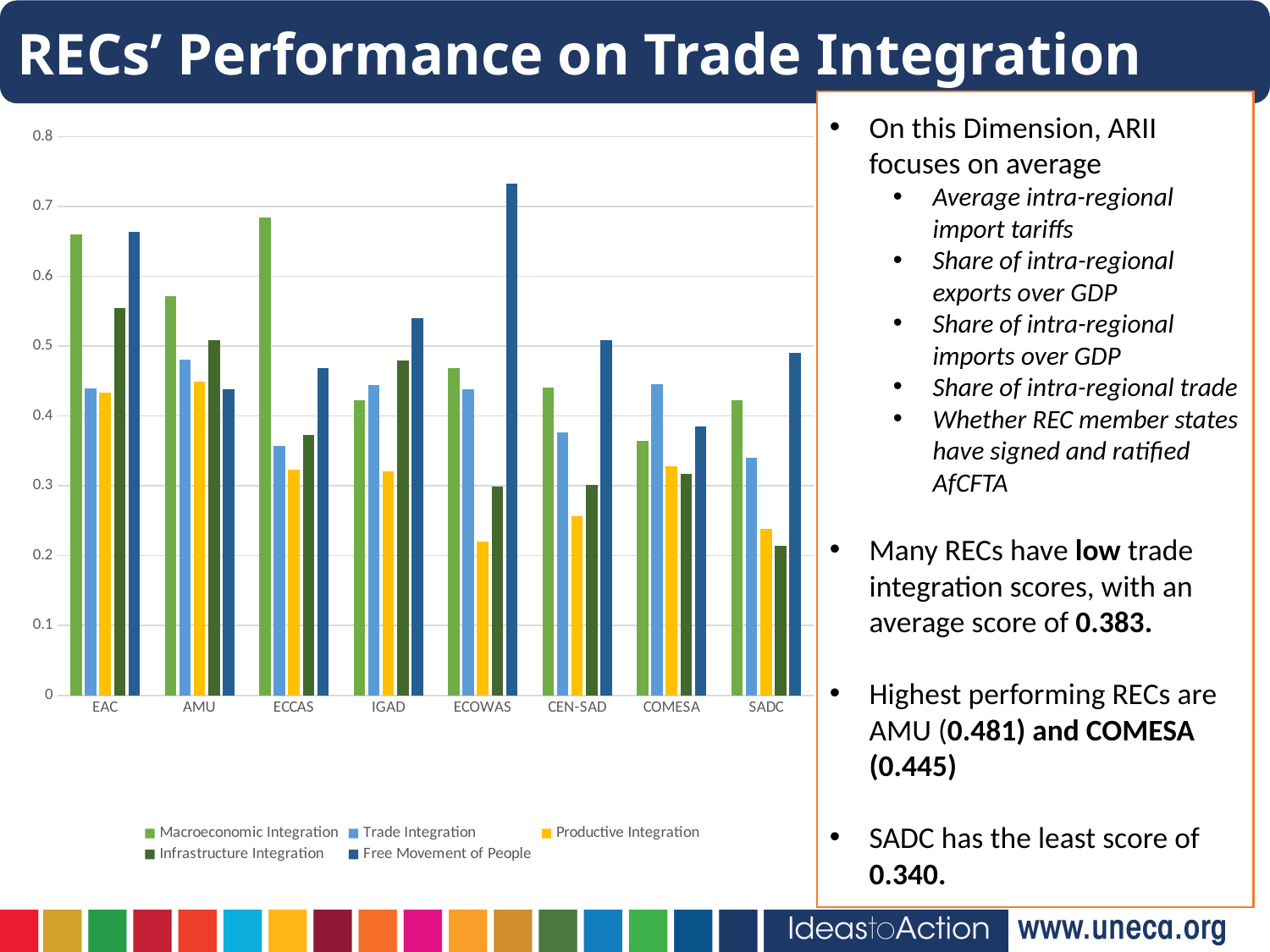
What kind of chart is shown on the slide? bar chart Which REC has the lowest Infrastructure Integration value? SADC Which colour represents Productive Integration in the chart's legend? yellow How many series does the chart's legend list? 5 Is the Macroeconomic Integration value for EAC greater or less than 0.6? greater Is the Infrastructure Integration value for SADC greater or less than 0.3? less How many RECs (categories) are shown on the x axis of the chart? 8 Is the Free Movement of People value for ECOWAS greater or less than 0.7? greater Which REC has the highest Macroeconomic Integration value? ECCAS For ECOWAS, which is larger: Infrastructure Integration or Free Movement of People? Free Movement of People For EAC, which is larger: Free Movement of People or Productive Integration? Free Movement of People Which REC has the highest Free Movement of People value? ECOWAS